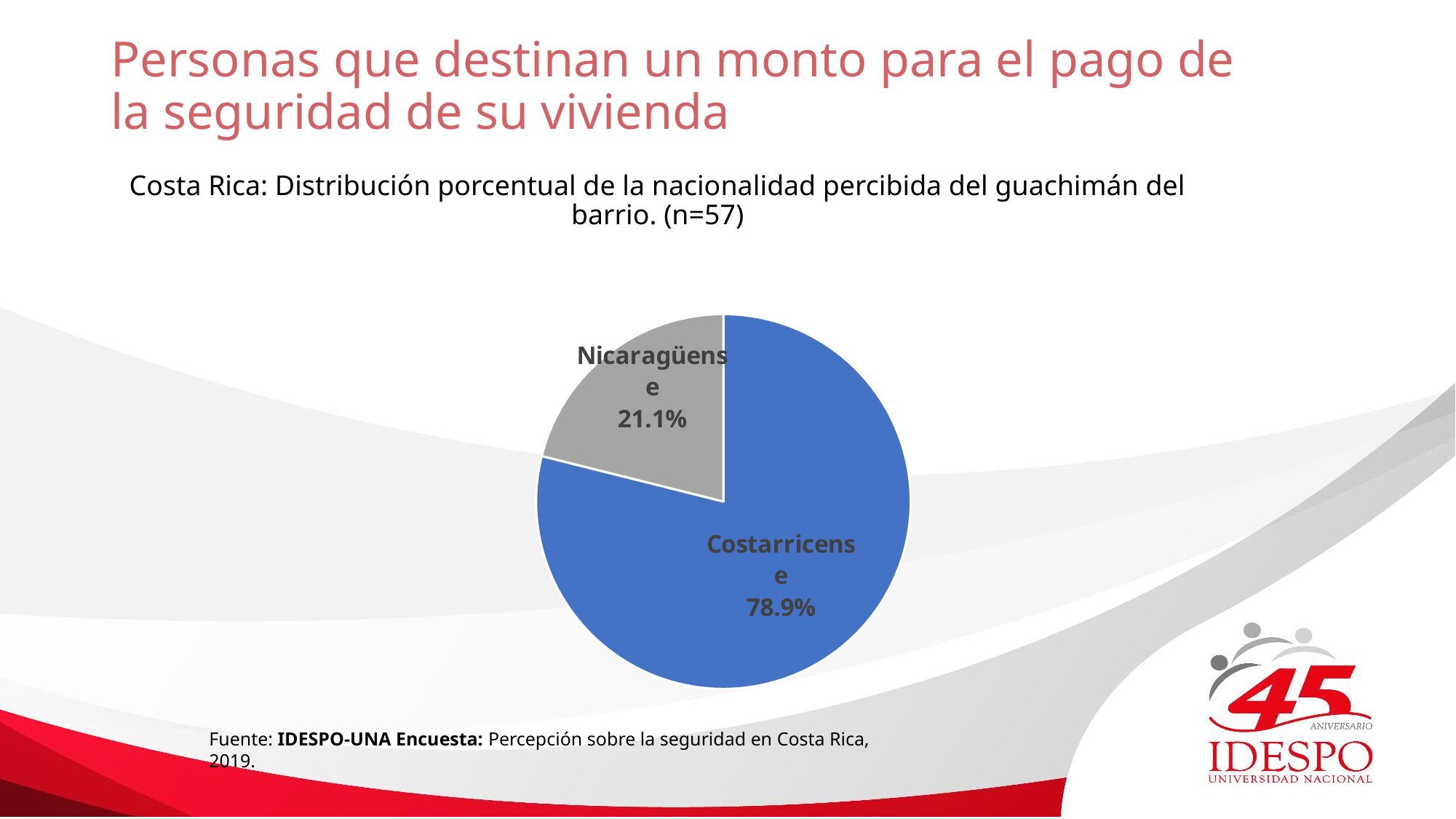
Which category has the smallest share of the pie? Nicaragüense Which is larger, the Costarricense slice or the Nicaragüense slice? Costarricense What colour is the Costarricense slice? Blue What is the difference in percentage points between the Costarricense and Nicaragüense slices? 57.8 What percentage of the pie corresponds to Costarricense? 78.9% What type of chart is shown on the slide? Pie chart Which category has the largest share of the pie? Costarricense What is the sample size (n) stated in the chart title? 57 How many slices does the pie chart have? 2 What percentage of the pie corresponds to Nicaragüense? 21.1%